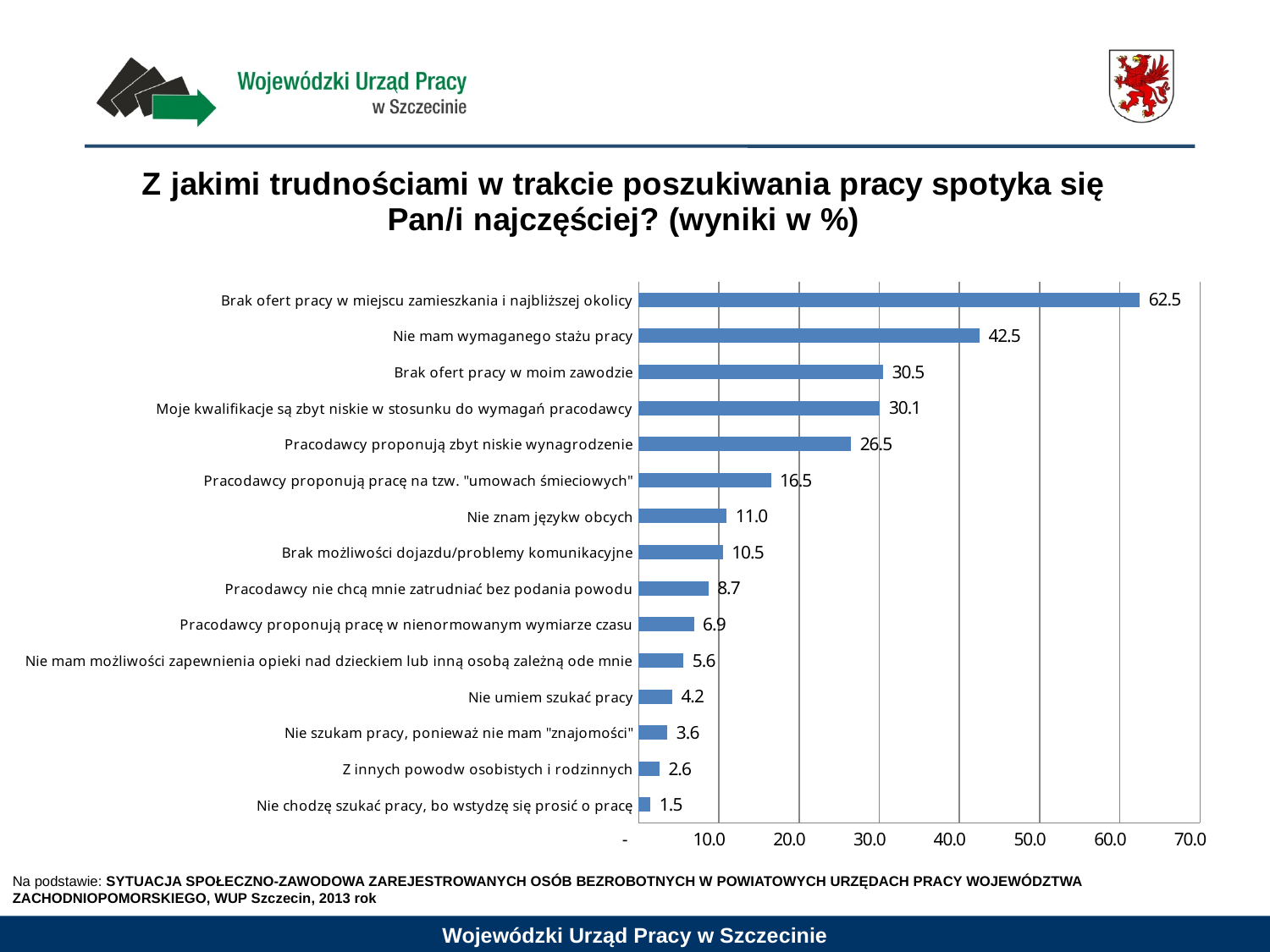
What is the value for "Pracodawcy proponują zbyt niskie wynagrodzenie"? 26.5 What is the value for "Brak ofert pracy w miejscu zamieszkania i najbliższej okolicy"? 62.5 What kind of chart is shown on the slide? bar chart Which category has the highest value? Brak ofert pracy w miejscu zamieszkania i najbliższej okolicy How many categories are shown in the chart? 15 What is the difference between the values for "Brak możliwości dojazdu/problemy komunikacyjne" and "Nie umiem szukać pracy"? 6.3 What is the difference between the values for "Brak ofert pracy w miejscu zamieszkania i najbliższej okolicy" and "Nie mam wymaganego stażu pracy"? 20.0 Which is larger: the value for "Pracodawcy proponują pracę na tzw. "umowach śmieciowych"" or the value for "Nie znam języków obcych"? Pracodawcy proponują pracę na tzw. "umowach śmieciowych" What is the title of the chart? Z jakimi trudnościami w trakcie poszukiwania pracy spotyka się Pan/i najczęściej? (wyniki w %) Which category has the lowest value? Nie chodzę szukać pracy, bo wstydzę się prosić o pracę What is the value for "Nie znam języków obcych"? 11.0 Is the value for "Nie mam wymaganego stażu pracy" greater or less than 40.0? greater